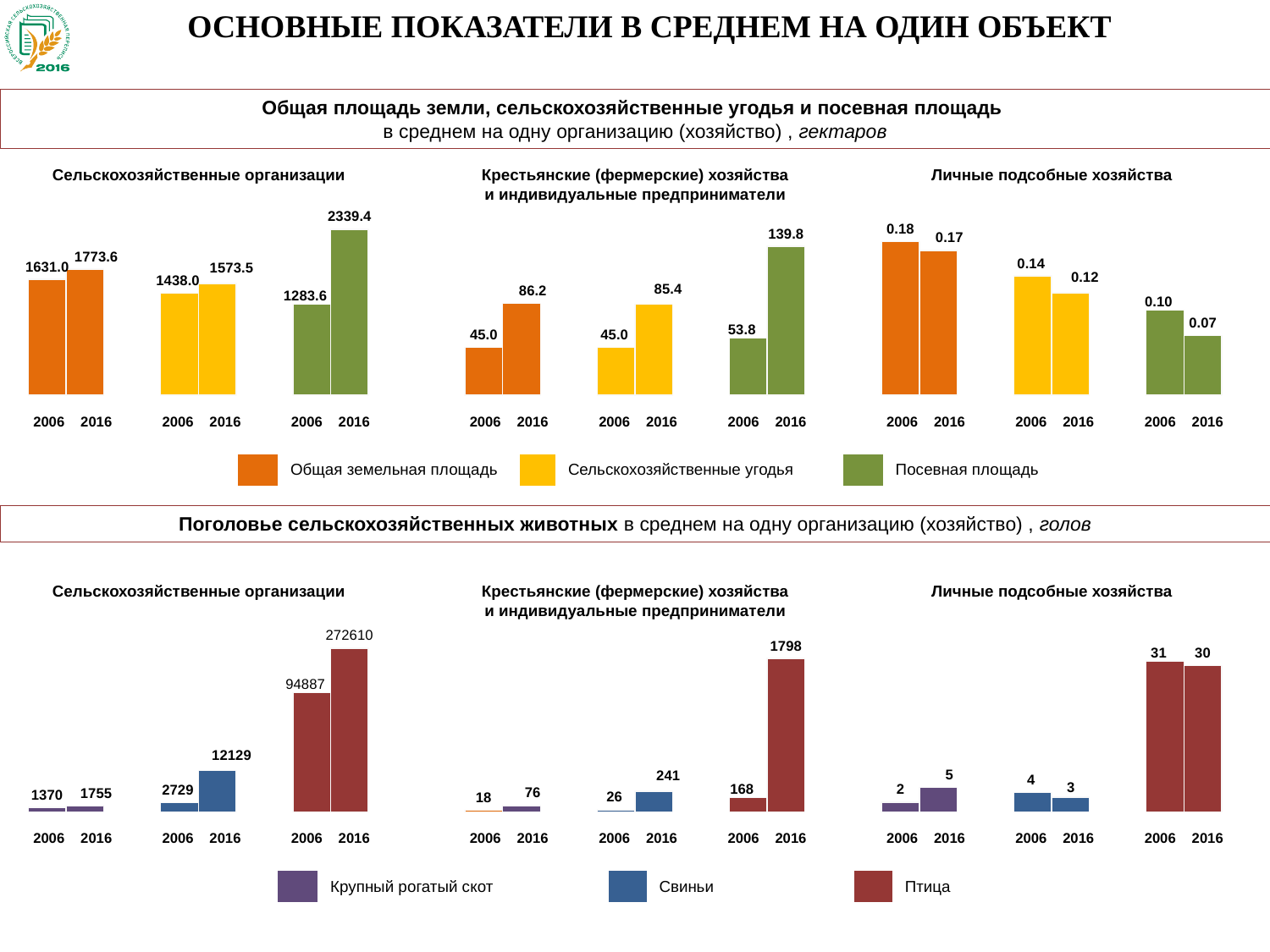
In the bottom-right chart (Личные подсобные хозяйства, livestock), which series has the lowest value in 2006? Крупный рогатый скот In the top-middle chart (Крестьянские (фермерские) хозяйства, land area), which series has the highest value in 2016? Посевная площадь In the top-left chart (Сельскохозяйственные организации, land area), by how much did Посевная площадь increase from 2006 to 2016? 1055.8 In the top-middle chart (Крестьянские (фермерские) хозяйства и индивидуальные предприниматели, land area), what is the value of Общая земельная площадь in 2006? 45.0 What type of chart is used in the top-left chart (Сельскохозяйственные организации, land area)? bar chart In the bottom-right chart (Личные подсобные хозяйства, livestock), which is larger: Свиньи in 2006 or Свиньи in 2016? Свиньи in 2006 In the top-right chart (Личные подсобные хозяйства, land area), what is the value of Посевная площадь in 2016? 0.07 How many series does the legend of the bottom row of charts (livestock) list? 3 In the top-right chart (Личные подсобные хозяйства, land area), do the values for each series rise or fall from 2006 to 2016? fall In the top-left chart (Сельскохозяйственные организации, land area), what is the value of Посевная площадь in 2016? 2339.4 In the bottom-middle chart (Крестьянские (фермерские) хозяйства, livestock), what is the difference between Птица in 2016 and Птица in 2006? 1630 In the bottom-left chart (Сельскохозяйственные организации, livestock), what is the value for Птица in 2016? 272610